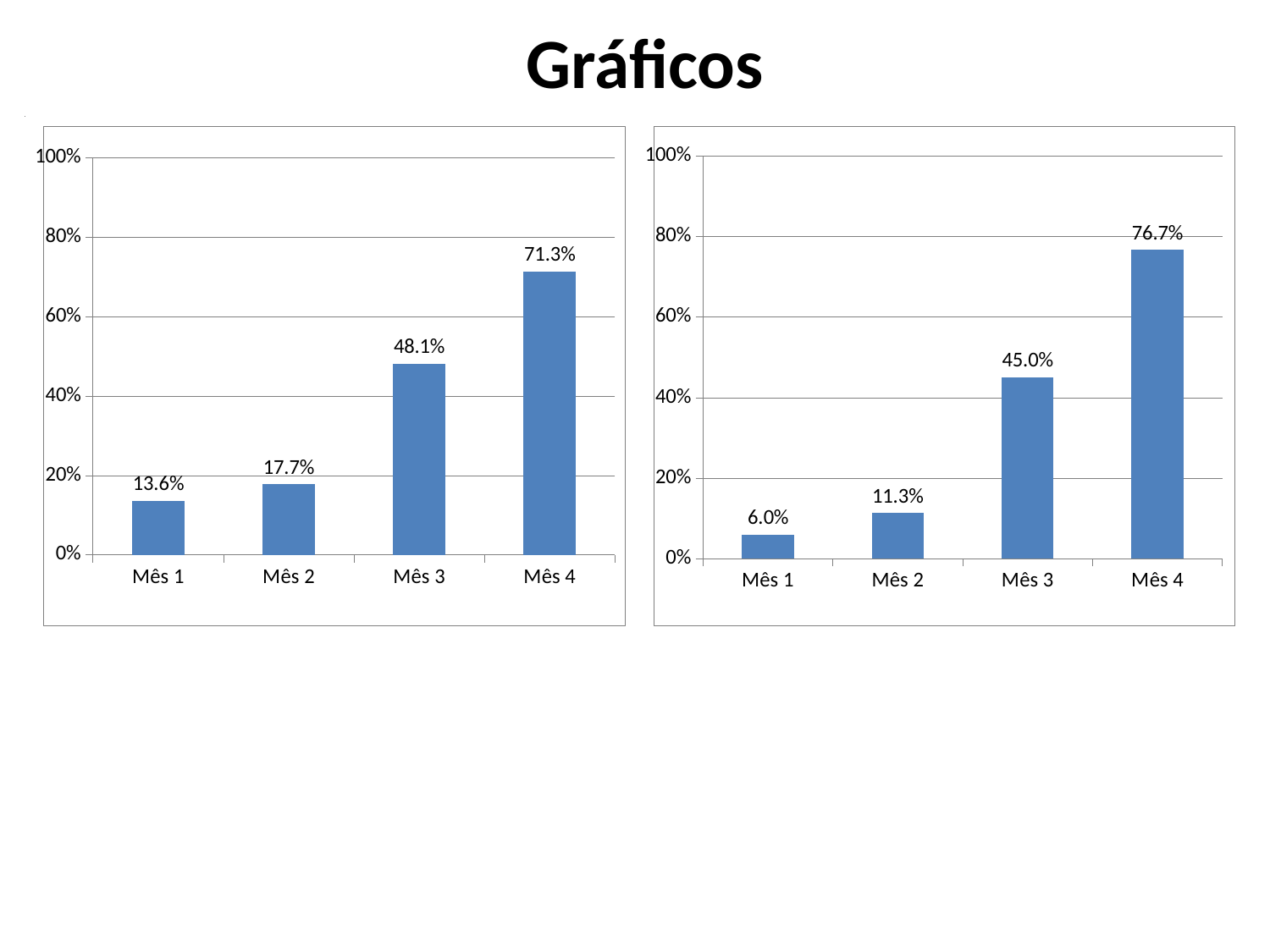
What kind of chart is the right chart? bar chart In the right chart, what is the value for Mês 1? 6.0% In the right chart, what is the difference between the values for Mês 2 and Mês 1? 5.3% In the right chart, which month has the lowest value? Mês 1 What is the title of the slide? Gráficos In the right chart, is the value for Mês 3 greater or less than 40%? greater How many categories are shown on the x axis of the left chart? 4 Which is larger: the value for Mês 4 in the left chart or the value for Mês 4 in the right chart? Mês 4 in the right chart In the left chart, do the values rise or fall from Mês 1 to Mês 4? rise In the left chart, which month has the highest value? Mês 4 In the left chart, what is the value for Mês 3? 48.1% In the left chart, what is the difference between the values for Mês 4 and Mês 3? 23.2%